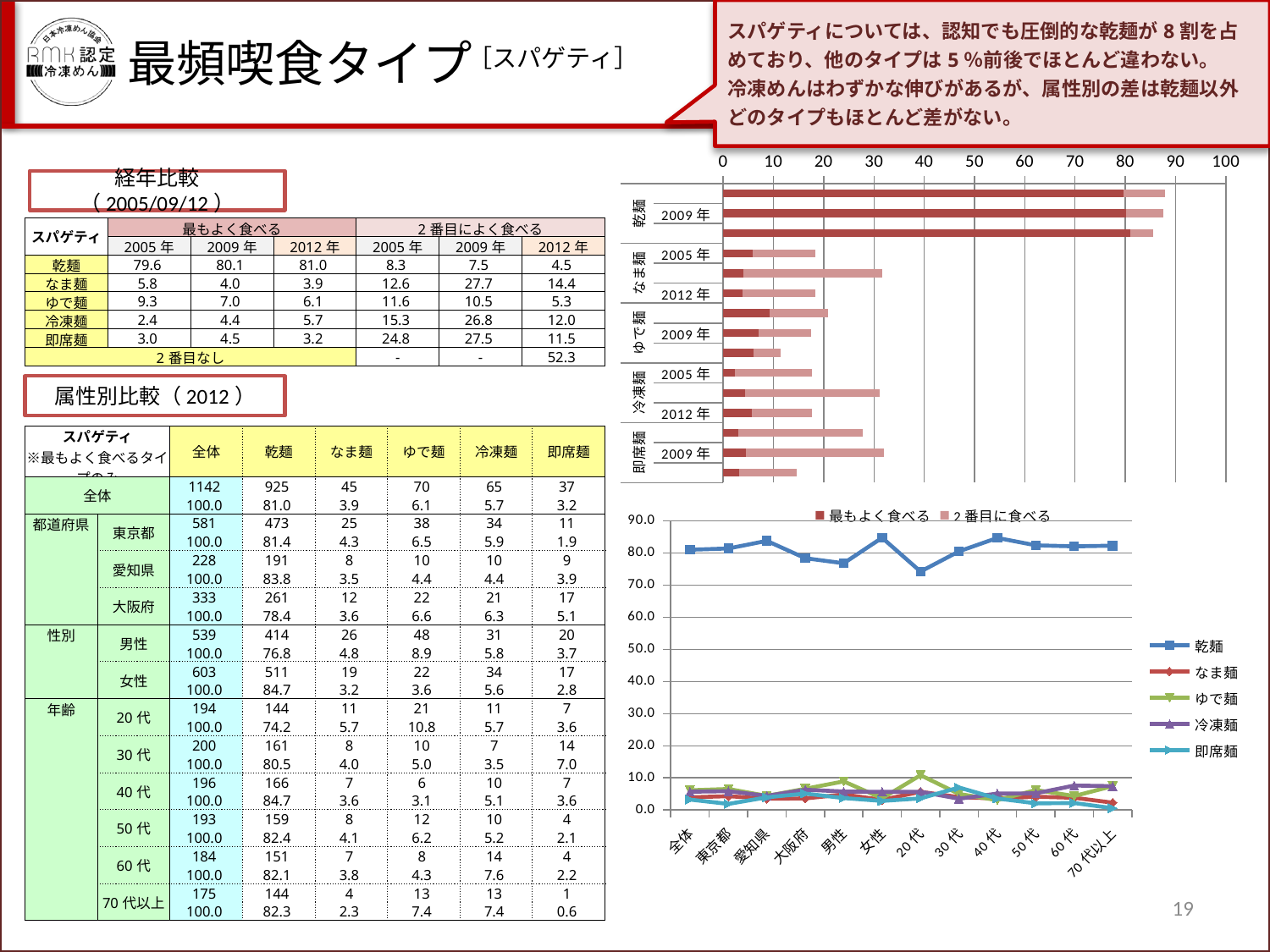
In the bottom-right line chart, what are the two legend entries shown above the plot area? 最もよく食べる, 2番目に食べる In the top-right bar chart, is the 最もよく食べる value for 乾麺 in 2009年 greater or less than 70? greater In the bottom-right line chart, is the 乾麺 value for 20代 greater or less than 80.0? less What kind of chart is the chart in the bottom right of the slide? line chart In the top-right bar chart, is the 最もよく食べる value for ゆで麺 in 2009年 greater or less than 20? less In the bottom-right line chart, which series has the highest values across all categories? 乾麺 In the top-right bar chart, how many series does the legend list? 2 What kind of chart is the chart in the top right of the slide? bar chart In the top-right bar chart, which noodle type has the longest bars? 乾麺 In the bottom-right line chart, how many series does the legend list? 5 In the bottom-right line chart, how many categories are shown on the x axis? 12